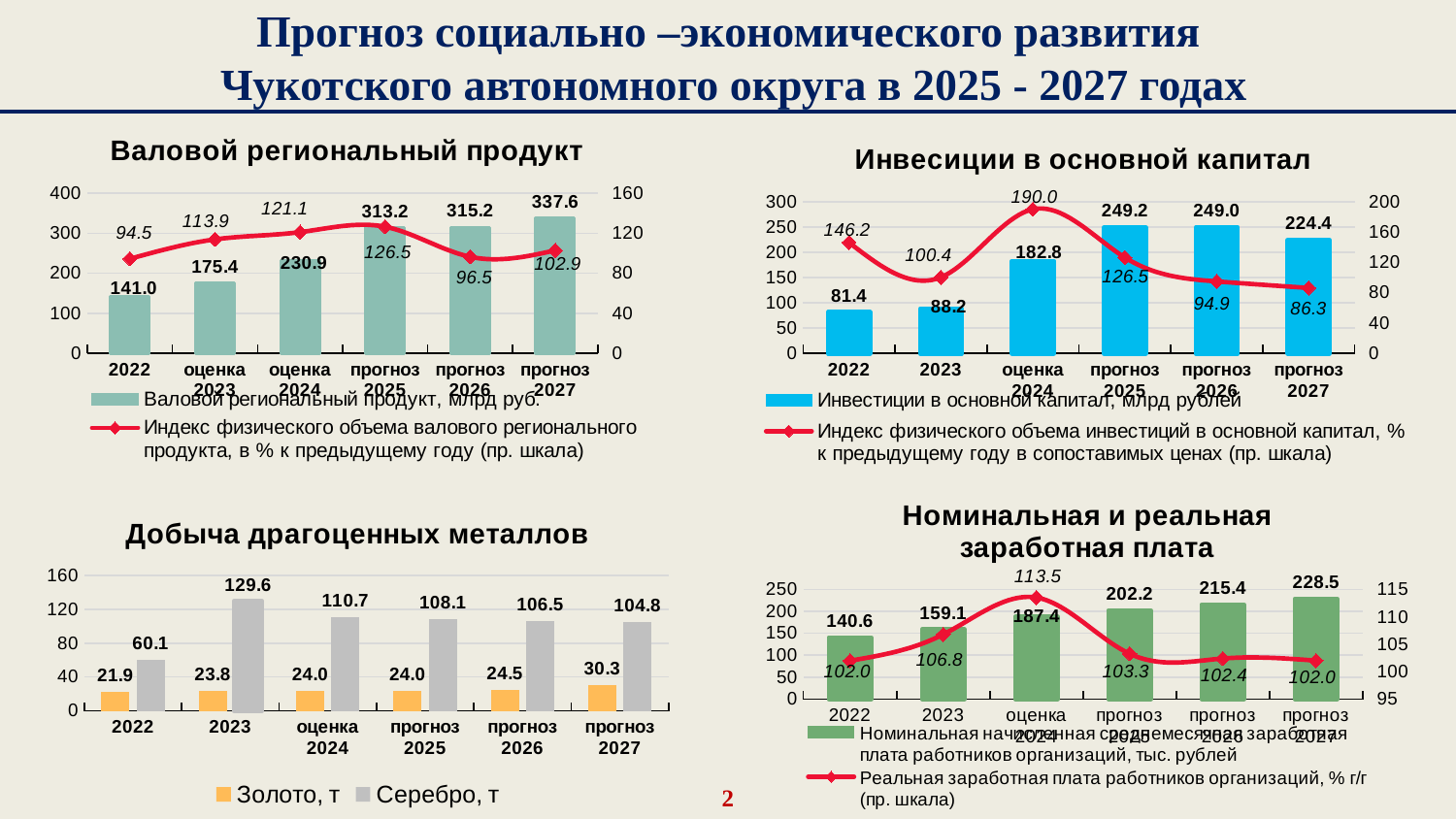
In the 'Добыча драгоценных металлов' chart, which is larger: Золото in прогноз 2027 or Золото in 2022? Золото in прогноз 2027 In the 'Номинальная и реальная заработная плата' chart, do the bar values rise or fall from 2022 to прогноз 2027? rise In the 'Валовой региональный продукт' chart, which year has the highest bar value? прогноз 2027 In the 'Инвесиции в основной капитал' chart, which year has the lowest bar value? 2022 In the 'Номинальная и реальная заработная плата' chart, what is the bar value for прогноз 2027? 228.5 In the 'Валовой региональный продукт' chart, what is the value of the bar for 2022? 141.0 In the 'Инвесиции в основной капитал' chart, what is the bar value for оценка 2024? 182.8 In the 'Инвесиции в основной капитал' chart, what is the highest value of the line series? 190.0 In the 'Валовой региональный продукт' chart, what is the line value (index of physical volume) for прогноз 2025? 126.5 In the 'Инвесиции в основной капитал' chart, what is the difference between the bar values for прогноз 2025 and 2023? 161.0 In the 'Добыча драгоценных металлов' chart, how many series does the legend list? 2 In the 'Добыча драгоценных металлов' chart, what is the value for Серебро in 2023? 129.6